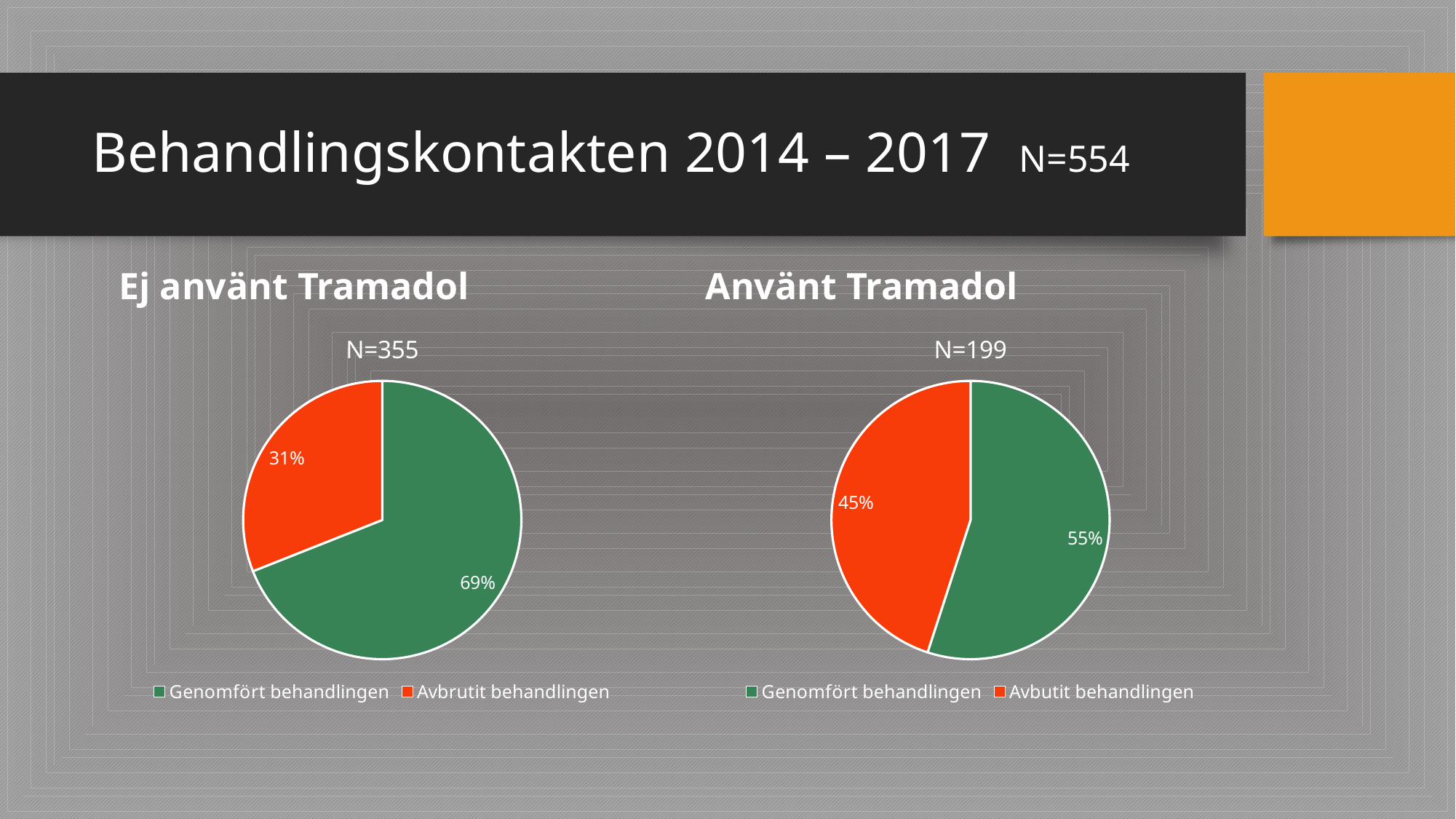
In the 'Ej använt Tramadol' pie chart, what share is labelled for Genomfört behandlingen? 69% In the 'Använt Tramadol' pie chart, which slice is the smallest? Avbutit behandlingen What N value is shown above the 'Ej använt Tramadol' pie chart? N=355 In the 'Använt Tramadol' pie chart, what share is labelled for Avbutit behandlingen? 45% In the 'Ej använt Tramadol' pie chart, what is the difference between the Genomfört behandlingen and Avbrutit behandlingen shares? 38% Which chart has the larger share for Genomfört behandlingen, 'Ej använt Tramadol' or 'Använt Tramadol'? Ej använt Tramadol In the 'Ej använt Tramadol' pie chart, which slice is the largest? Genomfört behandlingen What kind of chart is used on this slide? Pie chart In the 'Ej använt Tramadol' pie chart, what share is labelled for Avbrutit behandlingen? 31% What N value is shown above the 'Använt Tramadol' pie chart? N=199 How many slices does the 'Använt Tramadol' pie chart have? 2 In the 'Använt Tramadol' pie chart, what share is labelled for Genomfört behandlingen? 55%